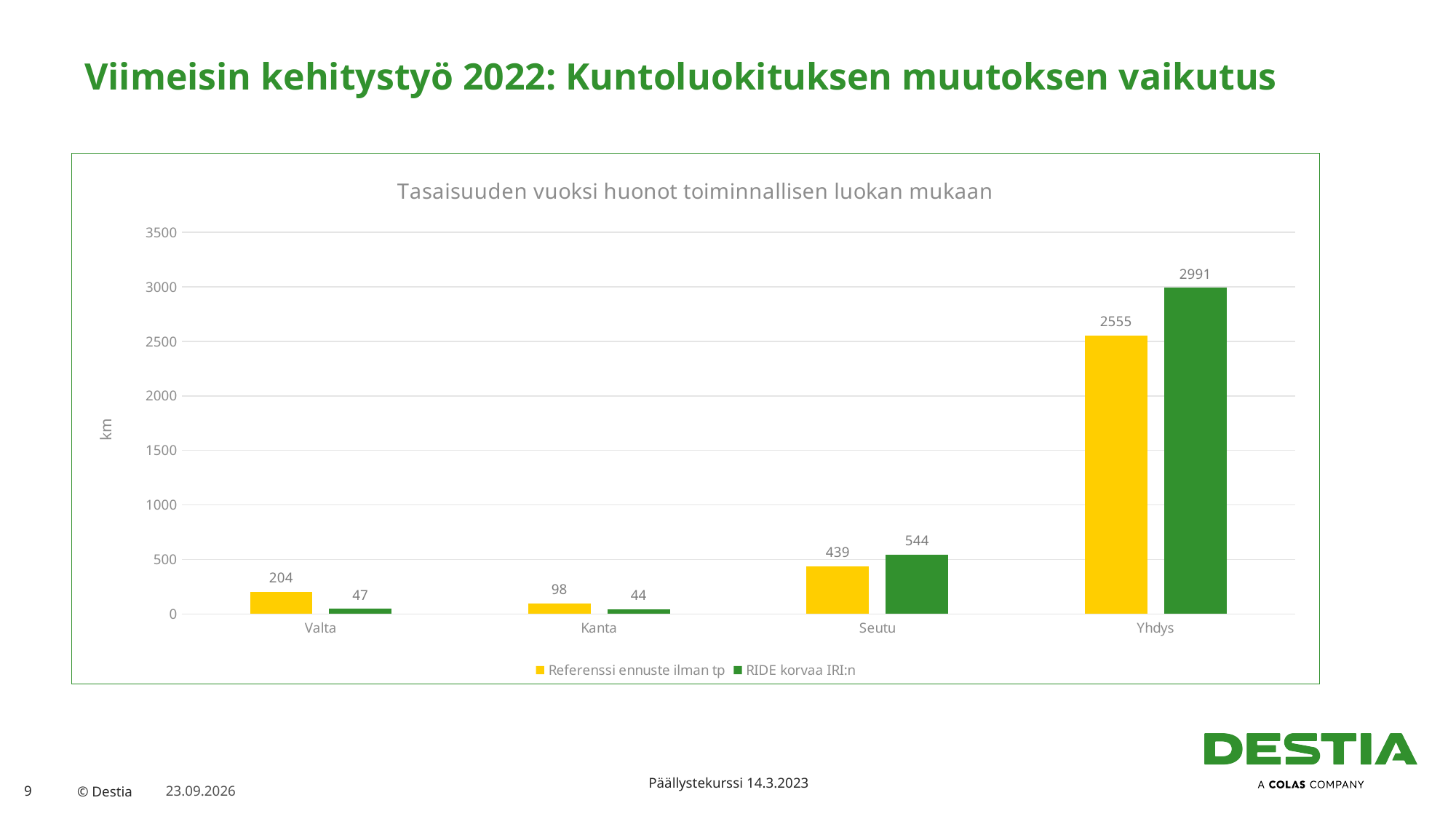
What is the value for Valta in the 'Referenssi ennuste ilman tp' series? 204 What kind of chart is shown on the slide? Bar chart What is the difference between the 'RIDE korvaa IRI:n' and 'Referenssi ennuste ilman tp' values for Yhdys? 436 Which category has the highest value in the 'Referenssi ennuste ilman tp' series? Yhdys Which category has the lowest value in the 'RIDE korvaa IRI:n' series? Kanta What is the title of the chart? Tasaisuuden vuoksi huonot toiminnallisen luokan mukaan How many series does the legend list? 2 What is the difference between the 'Referenssi ennuste ilman tp' and 'RIDE korvaa IRI:n' values for Valta? 157 What is the value for Seutu in the 'RIDE korvaa IRI:n' series? 544 How many categories are shown on the x axis? 4 For Seutu, which series has the larger value: 'Referenssi ennuste ilman tp' or 'RIDE korvaa IRI:n'? RIDE korvaa IRI:n What is the value for Yhdys in the 'RIDE korvaa IRI:n' series? 2991